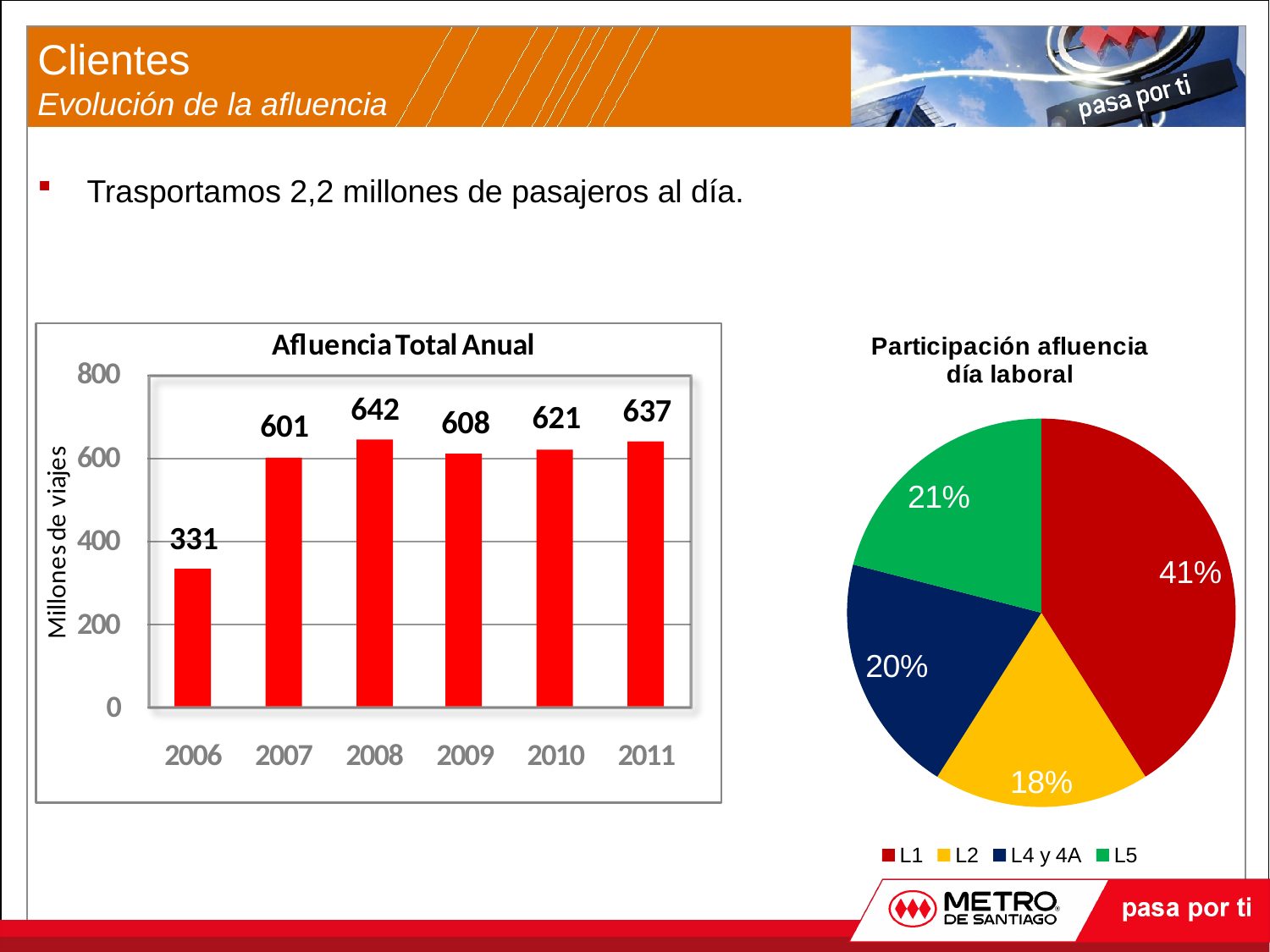
In the 'Participación afluencia día laboral' pie chart, which line has the smallest share? L2 In the 'Afluencia Total Anual' chart, what is the value for 2006? 331 In the 'Afluencia Total Anual' chart, which year has the lowest value? 2006 In the 'Afluencia Total Anual' chart, which is larger, the value for 2009 or the value for 2007? 2009 How many entries does the legend of the 'Participación afluencia día laboral' pie chart list? 4 In the 'Afluencia Total Anual' chart, what is the y-axis label? Millones de viajes In the 'Afluencia Total Anual' chart, which year has the highest value? 2008 What kind of chart is 'Afluencia Total Anual'? bar chart In the 'Afluencia Total Anual' chart, what is the difference between the values for 2011 and 2010? 16 In the 'Participación afluencia día laboral' pie chart, what share does L1 have? 41% In the 'Afluencia Total Anual' chart, what is the value for 2008? 642 In the 'Afluencia Total Anual' chart, how many years are shown on the x axis? 6